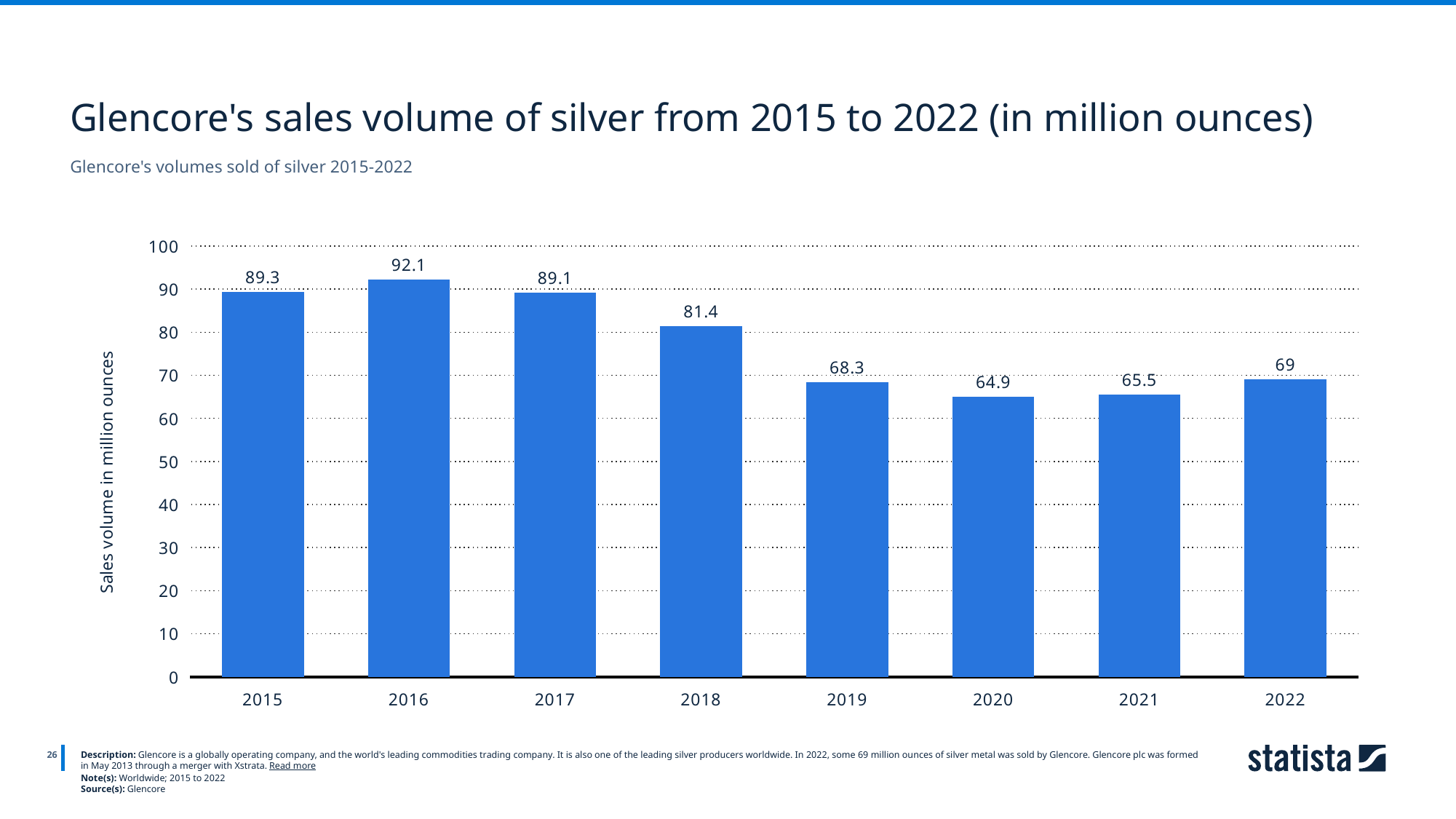
What is the difference between the sales volume in 2021 and in 2022? 3.5 Is the value for 2017 greater or less than 80? greater How many years are shown on the chart? 8 What is the difference between the sales volume in 2016 and in 2020? 27.2 Did the sales volume of silver generally rise or fall from 2016 to 2020? Fall What kind of chart is shown on the slide? Bar chart What was Glencore's sales volume of silver in 2018? 81.4 Which year had the highest sales volume of silver? 2016 Which year had a larger sales volume of silver, 2015 or 2019? 2015 What was Glencore's sales volume of silver in 2022? 69 Which year had the lowest sales volume of silver? 2020 What is the label of the y axis? Sales volume in million ounces